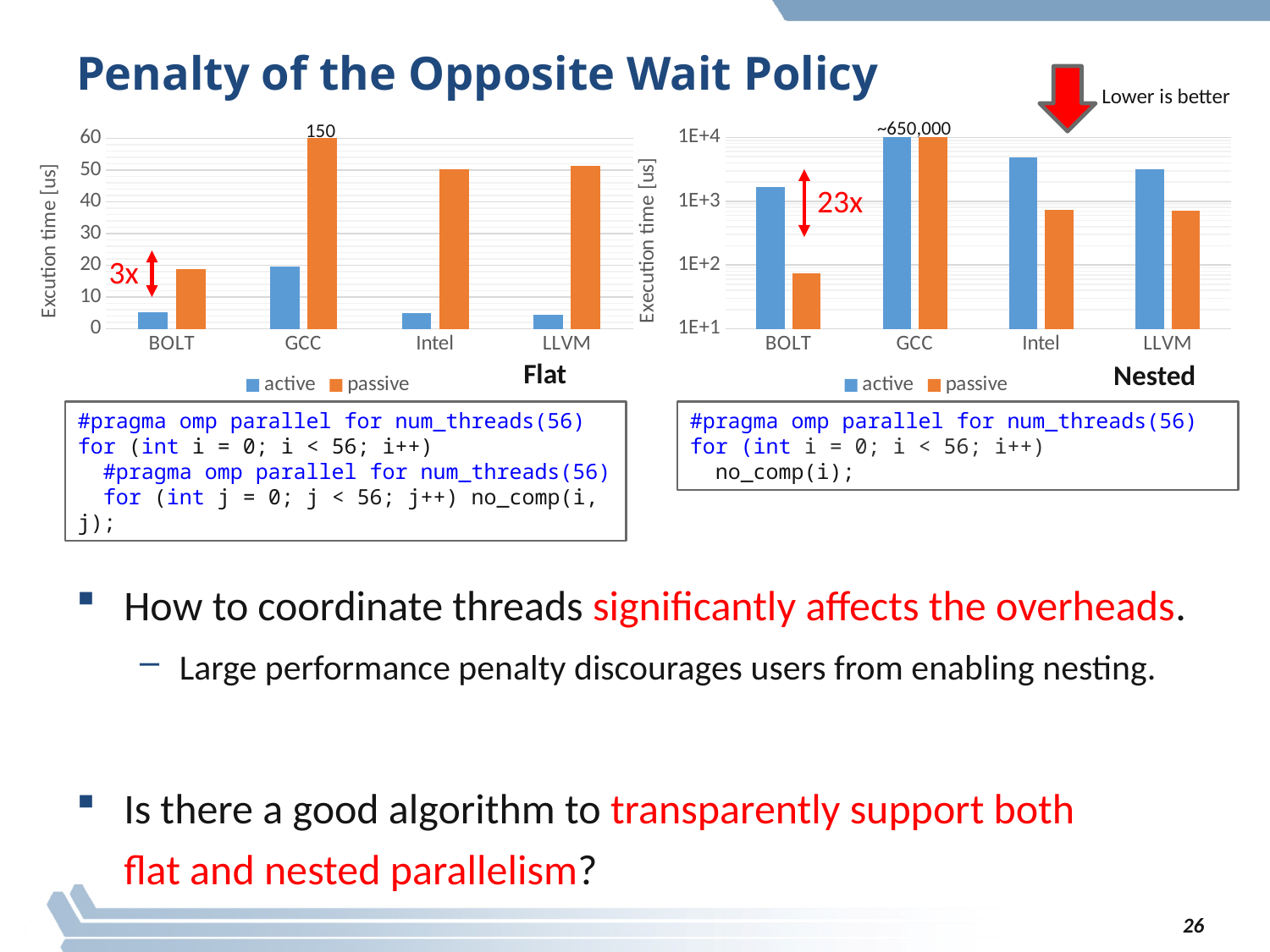
In the Flat chart on the left, which category has the highest passive value? GCC In the Nested chart on the right, which is larger for Intel, the active value or the passive value? active In the Flat chart on the left, is the value for BOLT passive greater or less than 10? greater In the Nested chart on the right, is the value for BOLT active greater or less than 1E+3? greater In the Nested chart on the right, which category has the highest active value? GCC In the Nested chart on the right, is the value for BOLT passive greater or less than 1E+2? less How many series does the legend of the Nested chart on the right list? 2 In the Flat chart on the left, what is the value printed for the passive series at GCC? 150 In the Nested chart on the right, which category has the lowest passive value? BOLT In the Flat chart on the left, which is larger for BOLT, the active value or the passive value? passive How many categories are shown on the x axis of the Flat chart on the left? 4